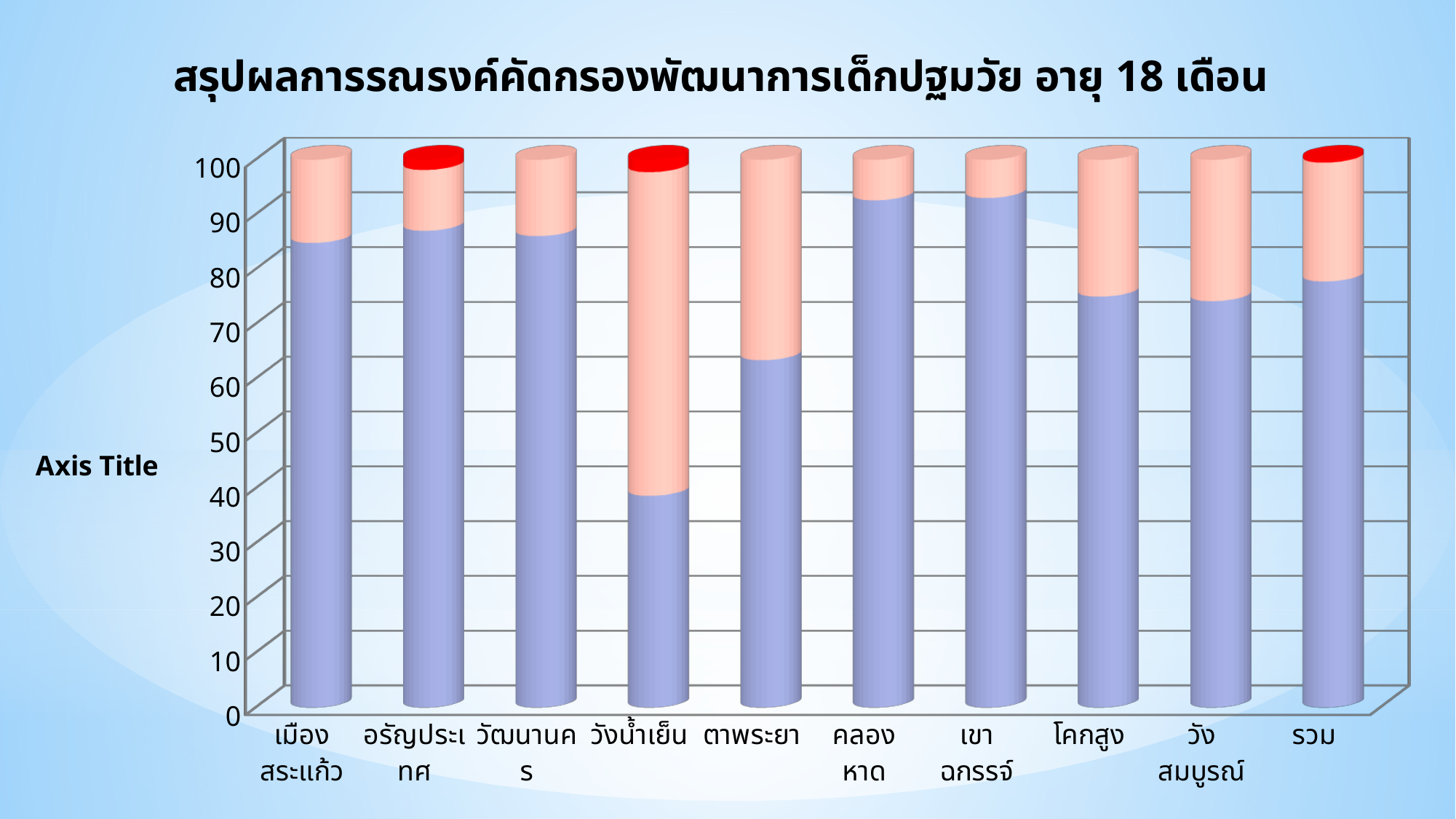
Which category has the lowest value for the blue (bottom) segment? วังน้ำเย็น Is the blue segment value for รวม greater or less than 70? greater Which has a larger blue segment, วังน้ำเย็น or ตาพระยา? ตาพระยา Is the blue segment value for ตาพระยา greater or less than 60? greater Is the blue segment value for โคกสูง greater or less than 80? less How many categories are shown along the x axis? 10 What is the title of the chart? สรุปผลการรณรงค์คัดกรองพัฒนาการเด็กปฐมวัย อายุ 18 เดือน What kind of chart is shown on the slide? bar chart What is the label shown on the vertical axis? Axis Title Which has a larger blue segment, โคกสูง or คลองหาด? คลองหาด